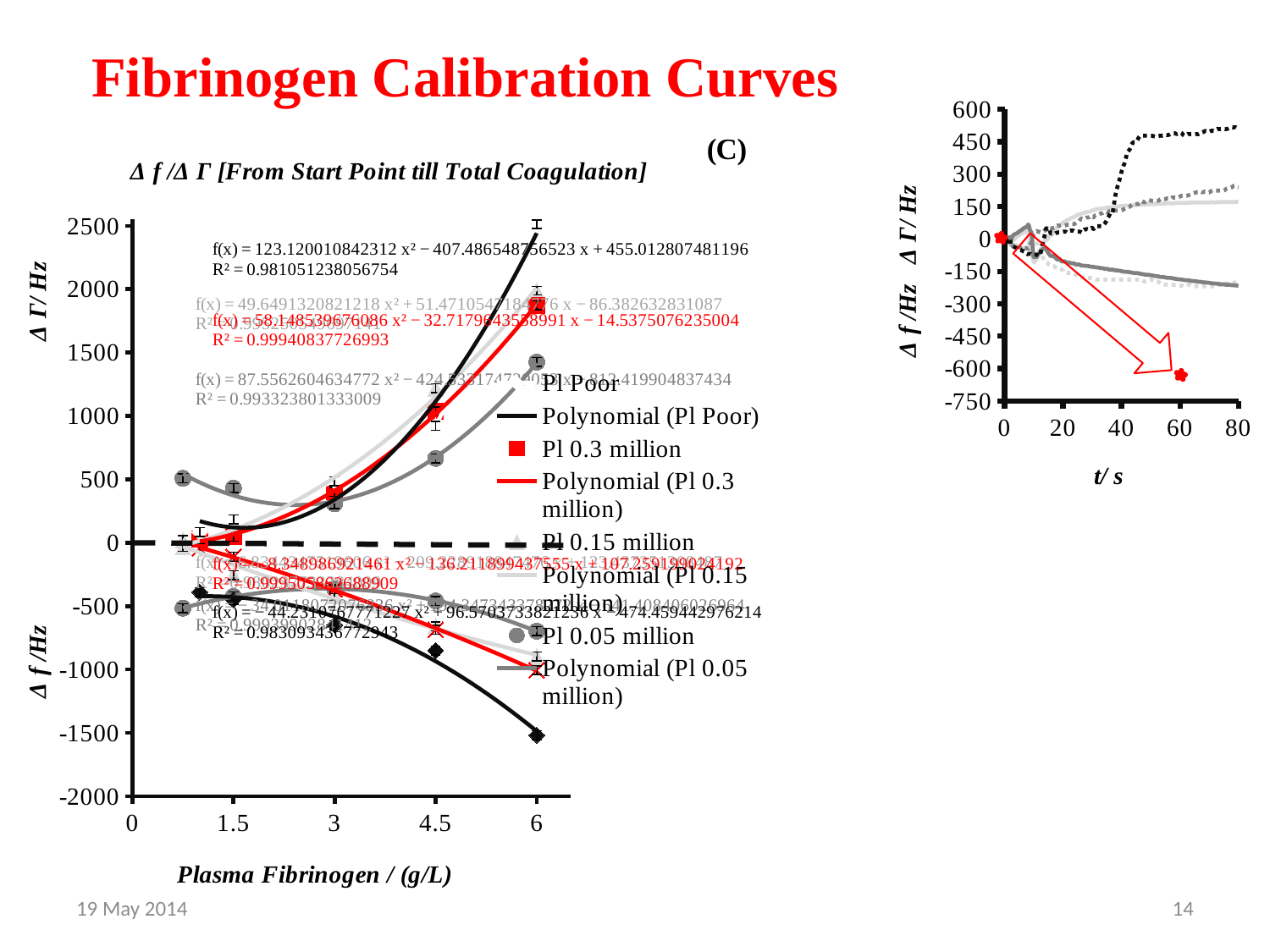
What is the title of the large chart on the left? Δ f /Δ Γ [From Start Point till Total Coagulation] In the large chart on the left, is the upper Pl Poor value at 6 g/L greater or less than 2000? greater In the large chart on the left, is the upper Pl 0.05 million value at 6 g/L greater or less than 1000? greater In the small chart on the right, what is the x-axis label? t/ s In the large chart on the left, is the upper Pl 0.3 million value at 6 g/L greater or less than 1500? greater How many entries does the legend of the large chart on the left list? 8 What is the x-axis label of the large chart on the left? Plasma Fibrinogen / (g/L) In the small chart on the right, what is the highest value shown on the y-axis? 600 What kind of chart is the large chart on the left? scatter chart In the large chart on the left, what R² value is printed in red for the Pl 0.3 million polynomial equation near the top of the plot? 0.99940837726993